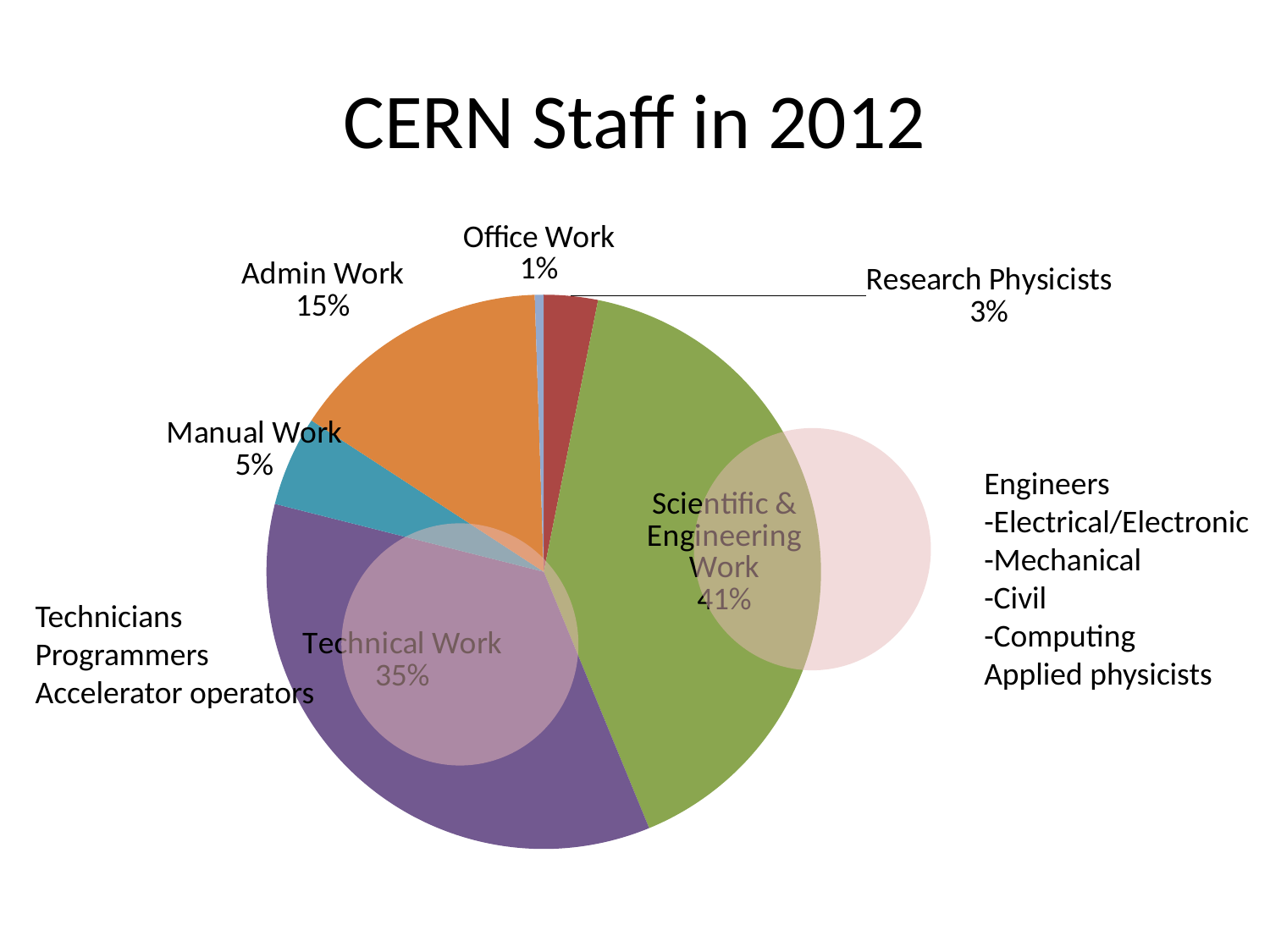
How many categories does the pie chart show? 6 What share of CERN staff in 2012 is Manual Work? 5% What share of CERN staff in 2012 is Technical Work? 35% Which is larger, the share for Admin Work or the share for Manual Work? Admin Work Which category has the smallest share of CERN staff in 2012? Office Work What kind of chart is shown on the slide? Pie chart What share of CERN staff in 2012 is Admin Work? 15% Which category has the largest share of CERN staff in 2012? Scientific & Engineering Work What share of CERN staff in 2012 is Research Physicists? 3% What is the difference in percentage points between Scientific & Engineering Work and Technical Work? 6 What is the title of the chart? CERN Staff in 2012 What share of CERN staff in 2012 is Scientific & Engineering Work? 41%